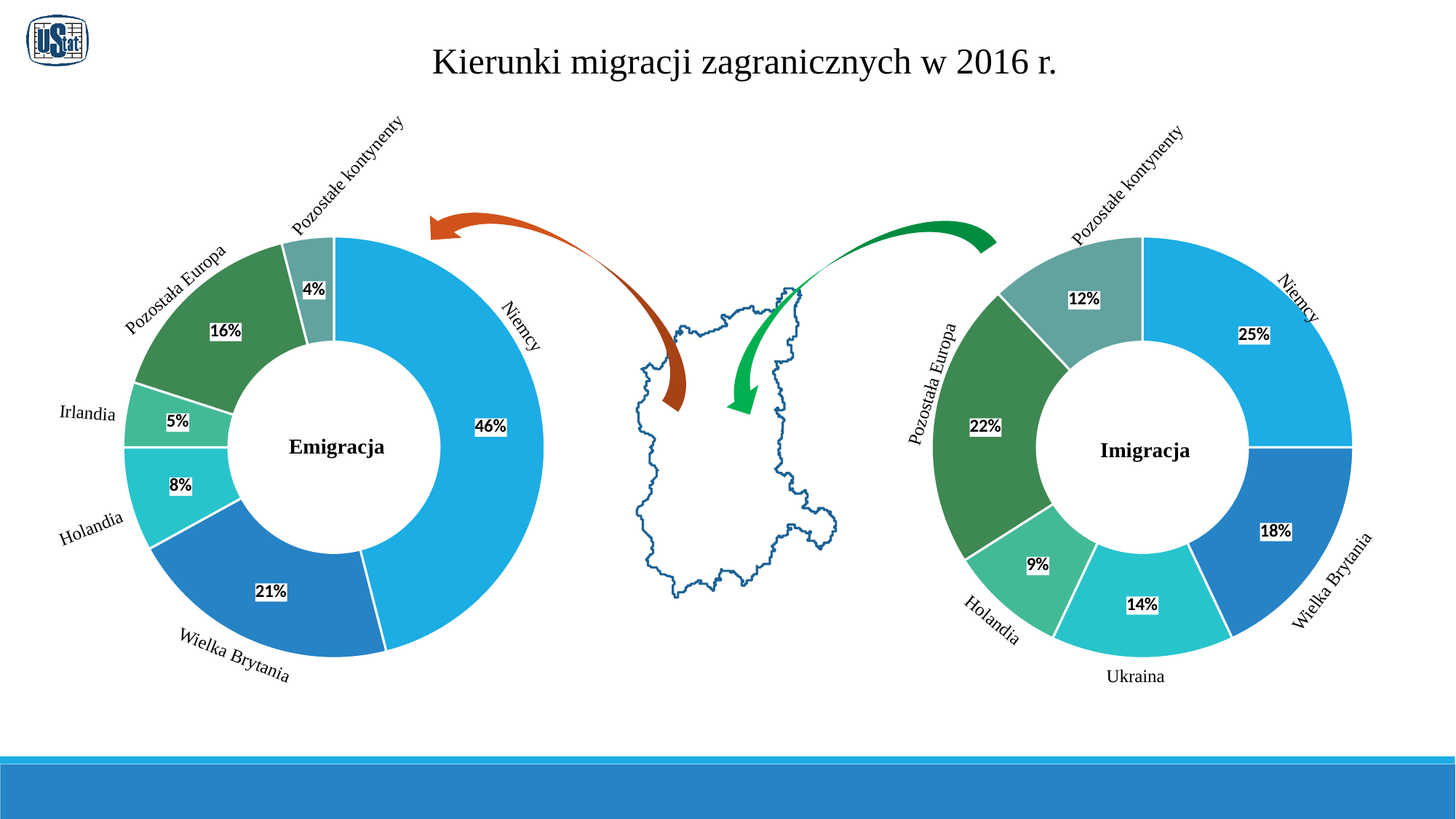
In the Emigracja chart, what is the difference between the shares for Niemcy and Wielka Brytania? 25% In the Imigracja chart, which category has the largest share? Niemcy In the Emigracja chart, which category has the smallest share? Pozostałe kontynenty How many categories does the Emigracja chart show? 6 In the Imigracja chart, which is larger, the share for Pozostała Europa or the share for Wielka Brytania? Pozostała Europa In the Imigracja chart, what share is shown for Ukraina? 14% In the Emigracja chart, what share is shown for Niemcy? 46% What kind of chart is the Imigracja chart? Doughnut chart In the Imigracja chart, which category has the smallest share? Holandia In the Emigracja chart, which category has the largest share? Niemcy How many categories does the Imigracja chart show? 6 What is the title of the slide? Kierunki migracji zagranicznych w 2016 r.